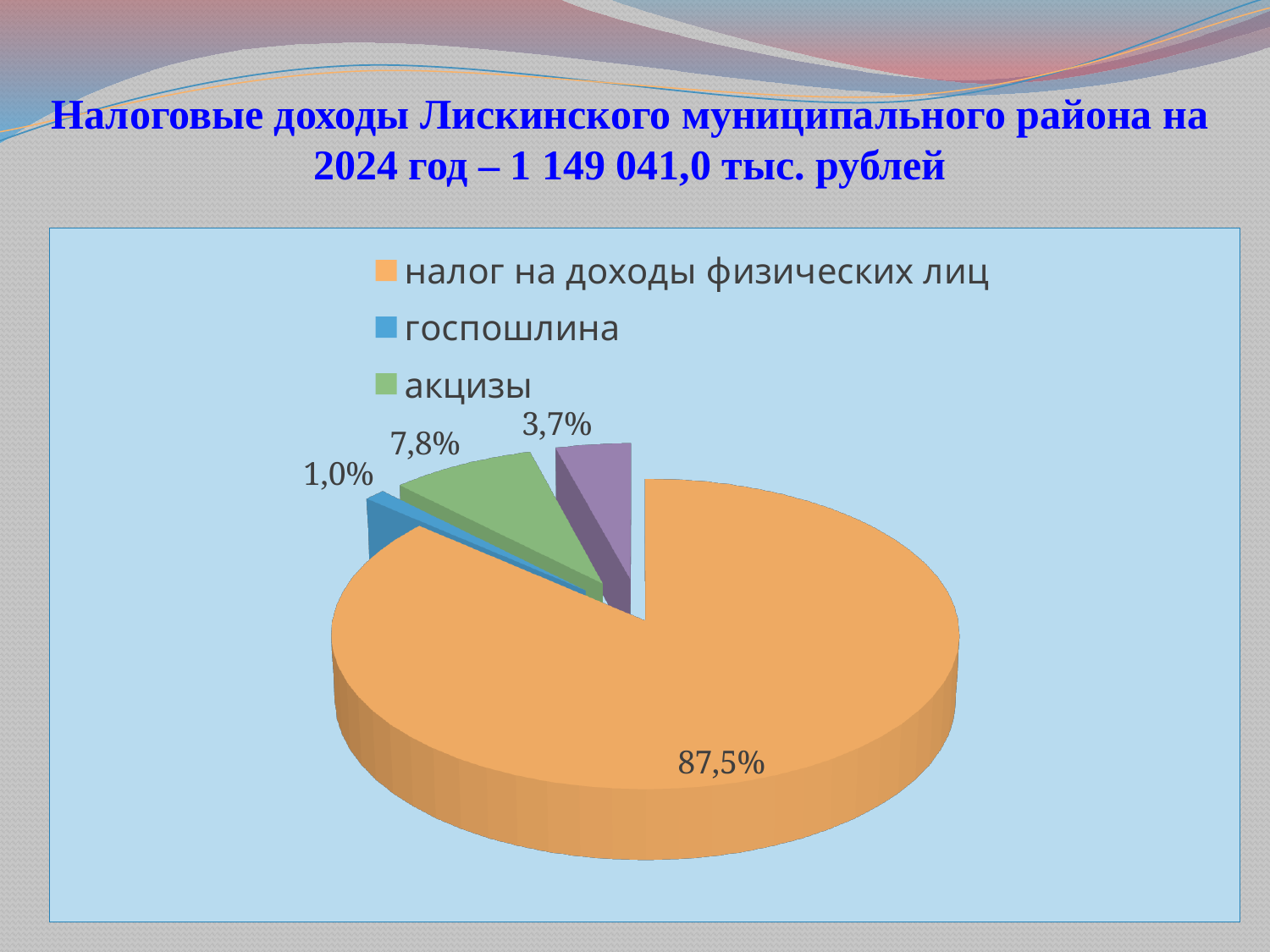
What is the difference between the share for налог на доходы физических лиц and the share for акцизы? 79,7% Which is larger, the share for акцизы or the share for госпошлина? акцизы How many entries does the legend list? 3 By how many percentage points does the share for акцизы exceed the share for госпошлина? 6,8% What percentage is shown for акцизы? 7,8% What share of the pie does налог на доходы физических лиц account for? 87,5% According to the slide title, what is the total tax revenue of the Лискинский municipal district for 2024? 1 149 041,0 тыс. рублей Which category has the smallest slice of the pie? госпошлина What percentage is shown for госпошлина? 1,0% What kind of chart is shown on the slide? pie chart How many slices does the pie chart have? 4 Which category has the largest slice of the pie? налог на доходы физических лиц